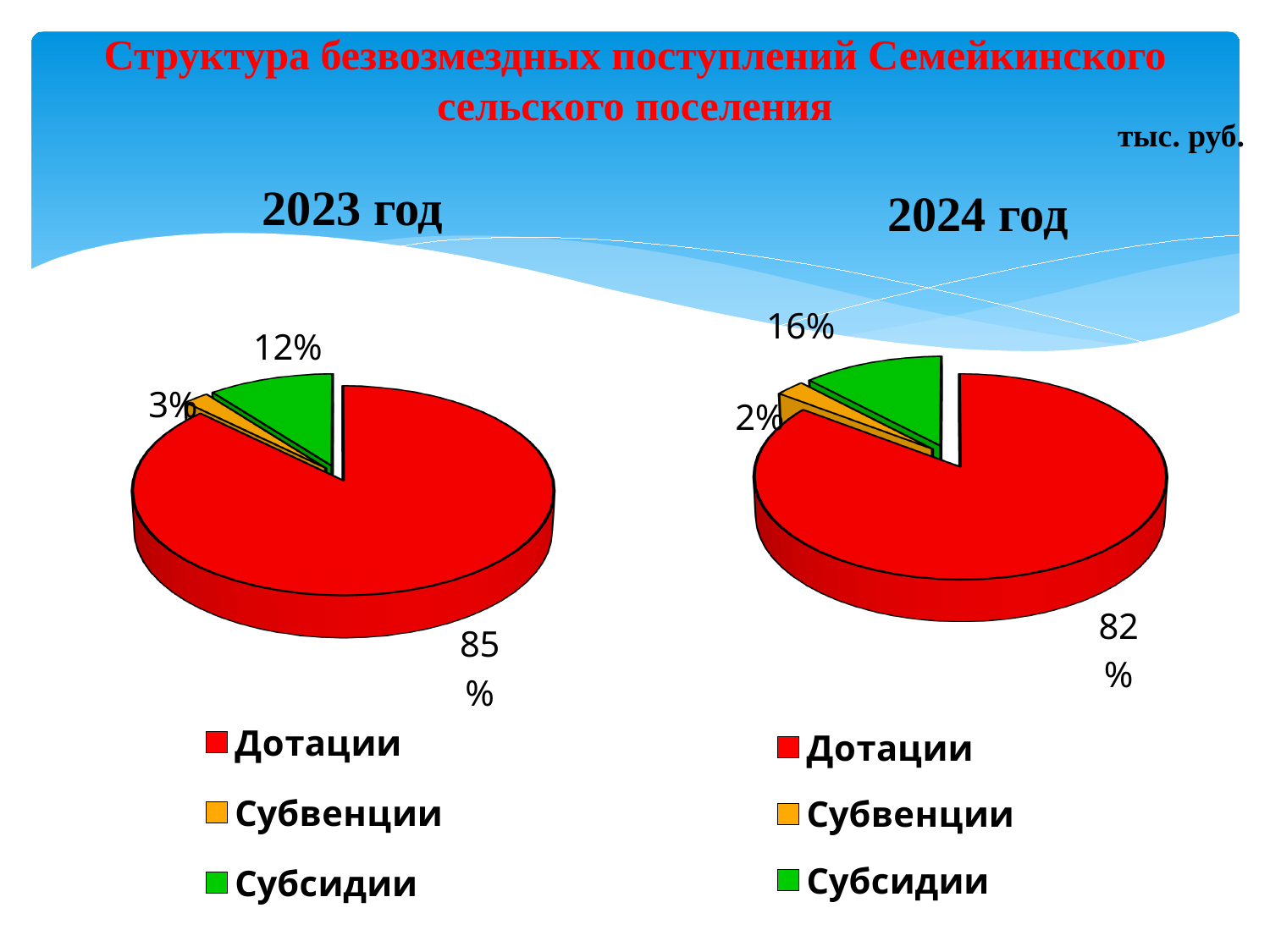
Is the share of Субсидии larger in the 2023 год chart or the 2024 год chart? 2024 год In the 2023 год chart, what is the difference between the shares of Субсидии and Субвенции? 9% How many entries does the legend of the 2023 год chart list? 3 In the 2023 год chart, what share does Дотации have? 85% In the 2024 год chart, what colour is the Субсидии slice? Green In the 2024 год chart, which category has the largest slice? Дотации In the 2023 год chart, which category has the smallest slice? Субвенции In the 2024 год chart, what share does Субвенции have? 2% In the 2024 год chart, what share does Субсидии have? 16% What kind of chart is the 2023 год chart? Pie chart How many categories does the 2024 год chart show? 3 In the 2023 год chart, what share does Субвенции have? 3%